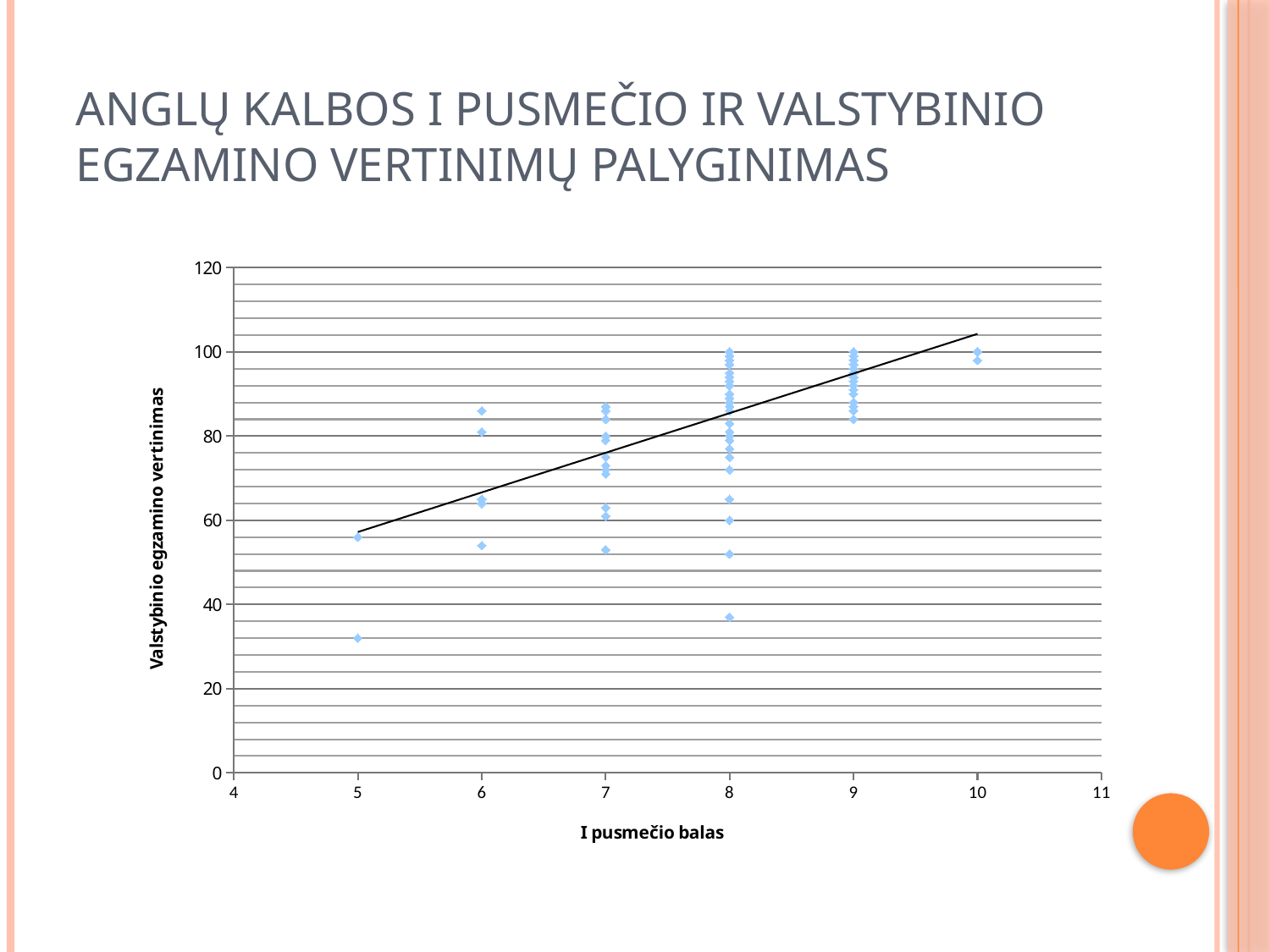
What is the title of the y axis? Valstybinio egzamino vertinimas Is the lowest state exam score for a first-semester score of 10 greater or less than 80? greater Is the highest state exam score for a first-semester score of 6 greater or less than 80? greater Which first-semester score has fewer plotted points, 5 or 8? 5 Is the lowest state exam score for a first-semester score of 5 greater or less than 40? less What kind of chart is shown on the slide? scatter chart How many points are plotted at a first-semester score of 5? 2 Do the state exam scores generally rise or fall as the first-semester score increases along the x axis? rise How many distinct first-semester score values (x positions) have points plotted? 6 What is the title of the x axis? I pusmečio balas